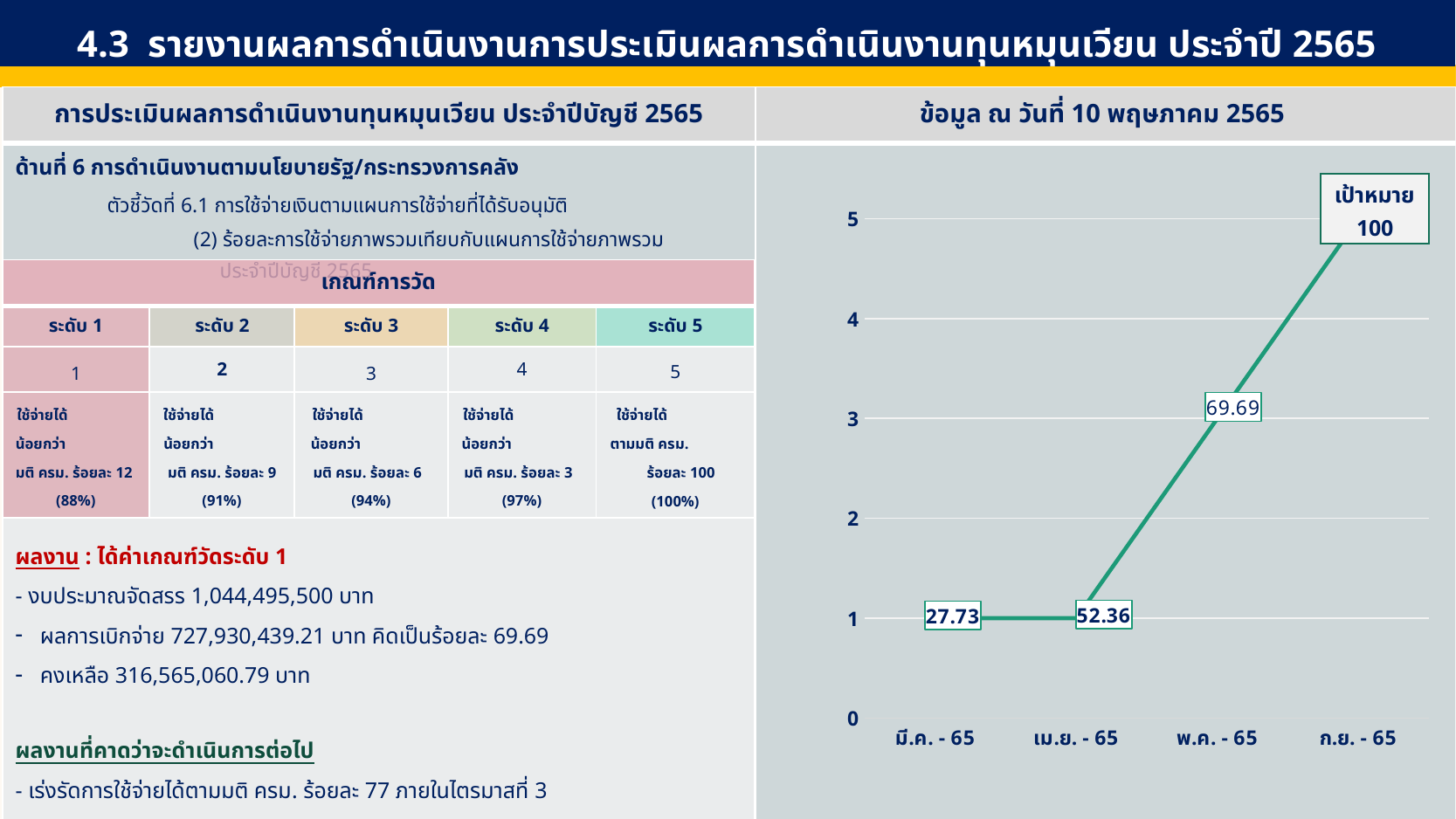
What is the difference between the labelled values for เม.ย. - 65 and มี.ค. - 65? 24.63 Which month on the line chart has the highest labelled value? ก.ย. - 65 What is the data label for มี.ค. - 65 on the line chart? 27.73 Do the values on the line chart rise or fall from มี.ค. - 65 to ก.ย. - 65? Rise What is the data label for พ.ค. - 65 on the line chart? 69.69 What kind of chart is shown on the right side of the slide? Line chart What target value (เป้าหมาย) is shown for ก.ย. - 65 on the line chart? 100 What is the difference between the labelled values for พ.ค. - 65 and เม.ย. - 65? 17.33 What is the data label for เม.ย. - 65 on the line chart? 52.36 Which month on the line chart has the lowest labelled value? มี.ค. - 65 Which has the larger labelled value on the line chart, เม.ย. - 65 or พ.ค. - 65? พ.ค. - 65 How many months are shown on the x axis of the line chart? 4